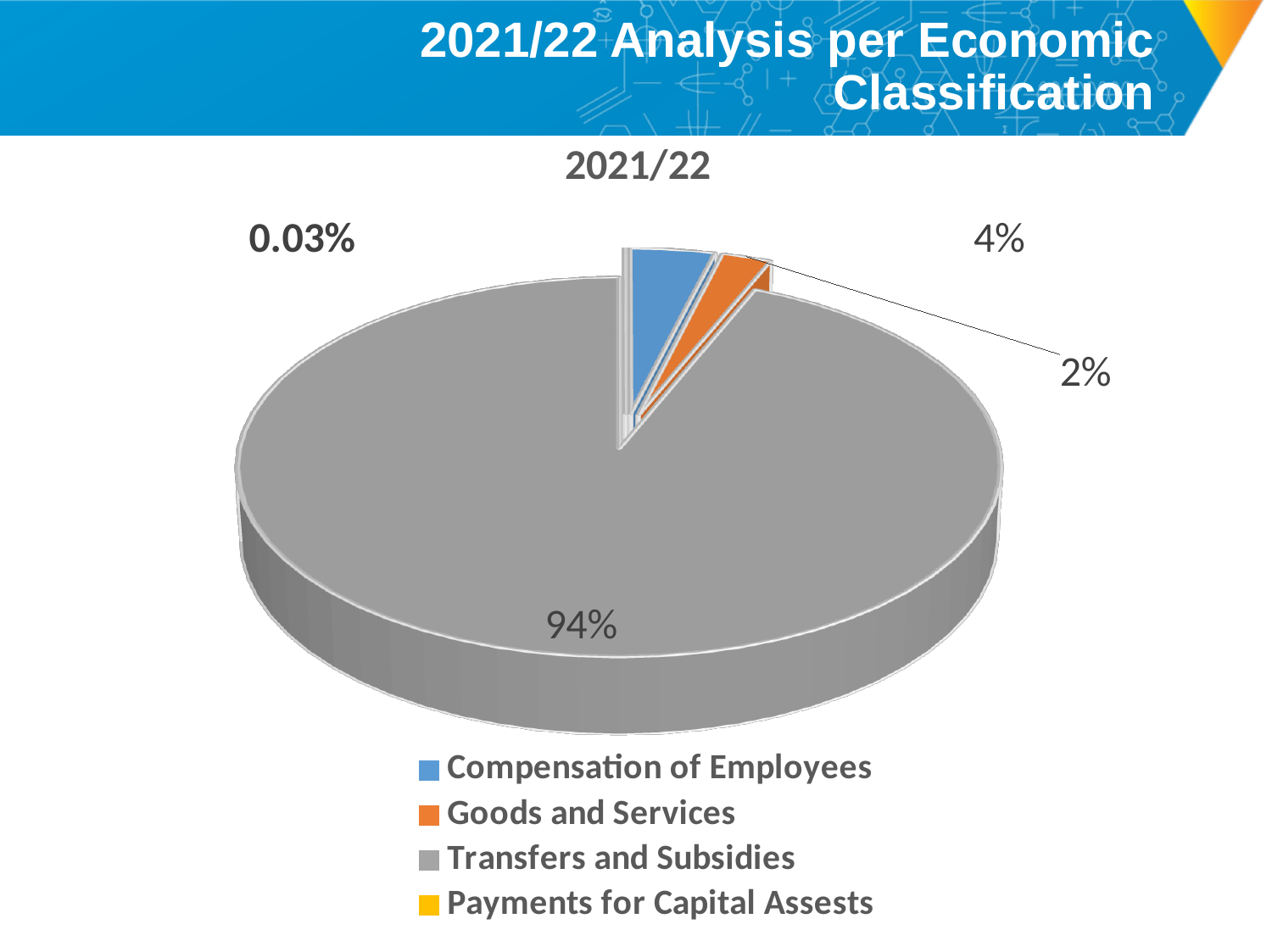
What share of the pie is Payments for Capital Assests? 0.03% What is the chart's title? 2021/22 What is the difference between the share for Transfers and Subsidies and the share for Compensation of Employees? 90% Which is larger, the share for Compensation of Employees or the share for Goods and Services? Compensation of Employees Which category has the largest share of the pie? Transfers and Subsidies What share of the pie is Goods and Services? 2% Which category has the smallest share of the pie? Payments for Capital Assests What kind of chart is shown on the slide? Pie chart What share of the pie is Transfers and Subsidies? 94% How many categories does the legend list? 4 What colour is the slice for Goods and Services? Orange